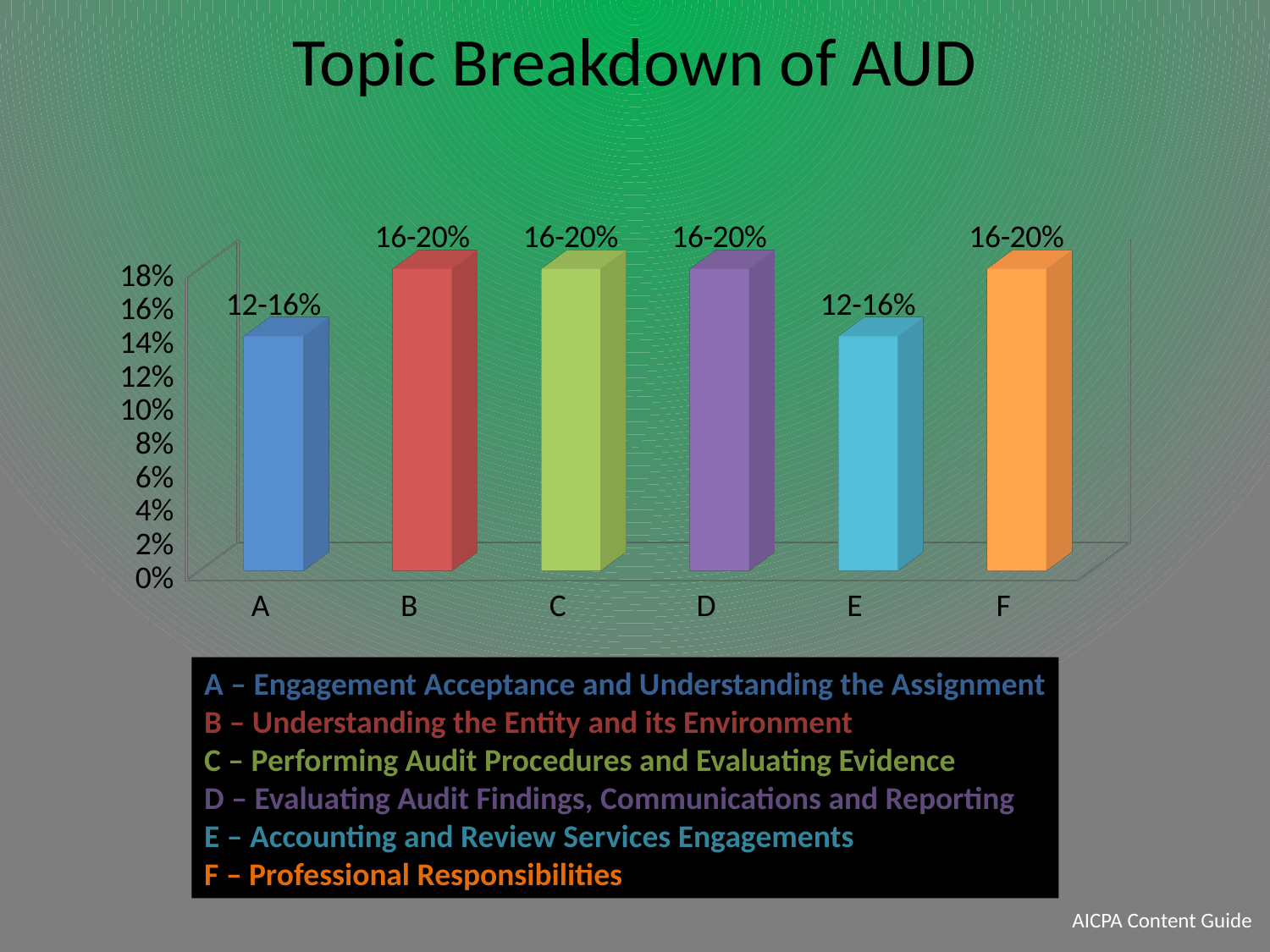
What is the title of the chart? Topic Breakdown of AUD Which is larger, the value for B or the value for A? B What is the data label shown for category E? 12-16% What is the data label shown for category F? 16-20% What kind of chart is shown on the slide? Bar chart What is the data label shown for category A? 12-16% What is the data label shown for category B? 16-20% Which categories have the lowest data label on the chart? A and E Is the value for E greater or less than 18%? less Is the value for A greater or less than 10%? greater Which is larger, the value for E or the value for D? D How many categories are plotted on the chart? 6